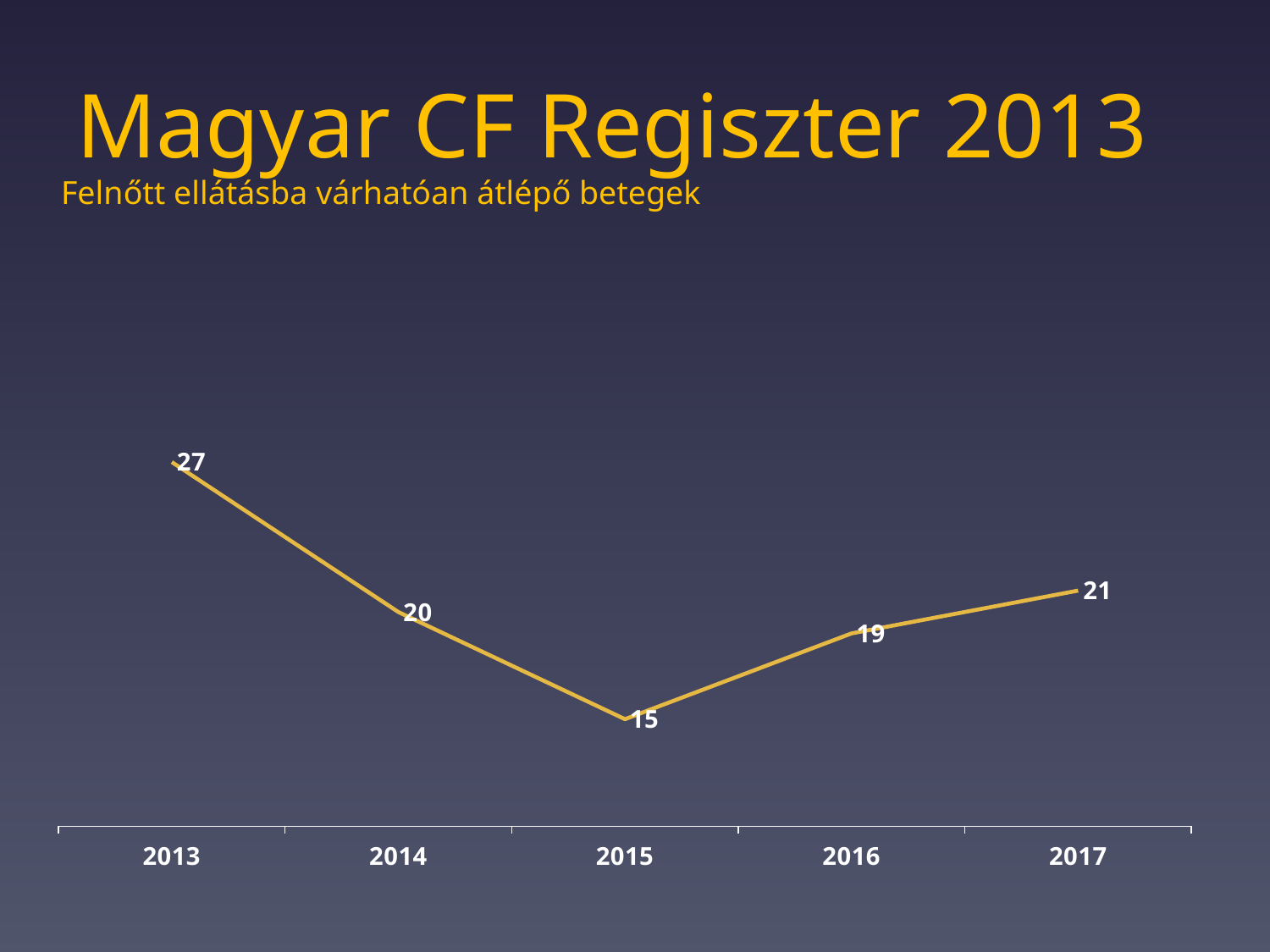
Do the values rise or fall from 2013 to 2015? fall What is the value for 2013? 27 Which is larger, the value for 2014 or the value for 2016? 2014 Which year has the lowest value? 2015 What is the value for 2017? 21 What is the difference between the values for 2017 and 2016? 2 What is the value for 2015? 15 What is the value for 2016? 19 Which year has the highest value? 2013 How many years are plotted on the chart? 5 What kind of chart is shown on the slide? line chart What is the difference between the values for 2013 and 2015? 12